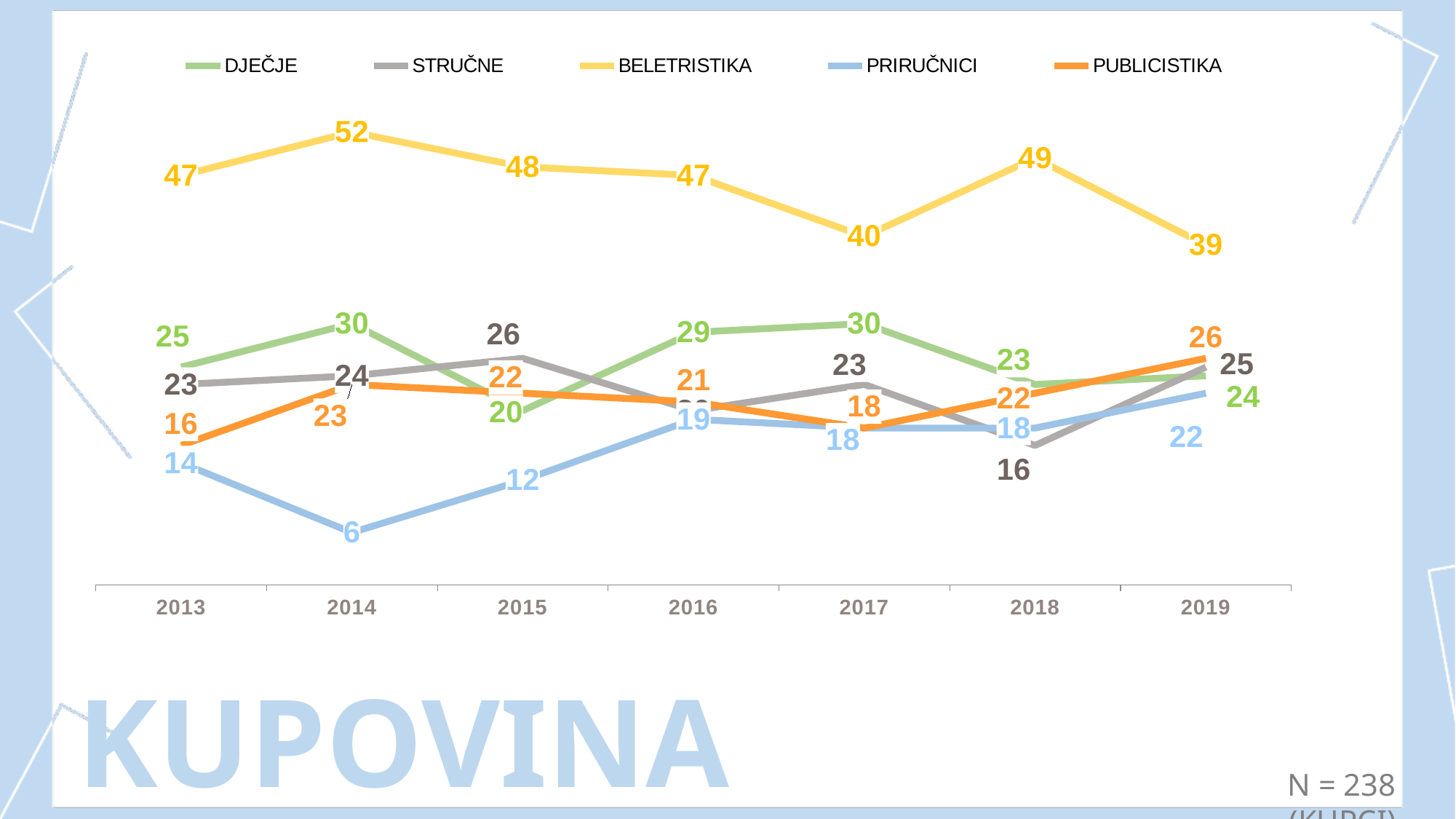
What is the value for BELETRISTIKA in 2014? 52 What is the value for PUBLICISTIKA in 2019? 26 How many years are shown on the x axis? 7 What is the value for STRUČNE in 2018? 16 How many series does the legend list? 5 Which is larger in 2017, the DJEČJE value or the STRUČNE value? DJEČJE What type of chart is shown on the slide? line chart In which year is the PRIRUČNICI value highest? 2019 What is the value for PRIRUČNICI in 2014? 6 What is the difference between the BELETRISTIKA values in 2014 and 2019? 13 In which year is the BELETRISTIKA value lowest? 2019 Does the BELETRISTIKA line rise or fall from 2018 to 2019? fall